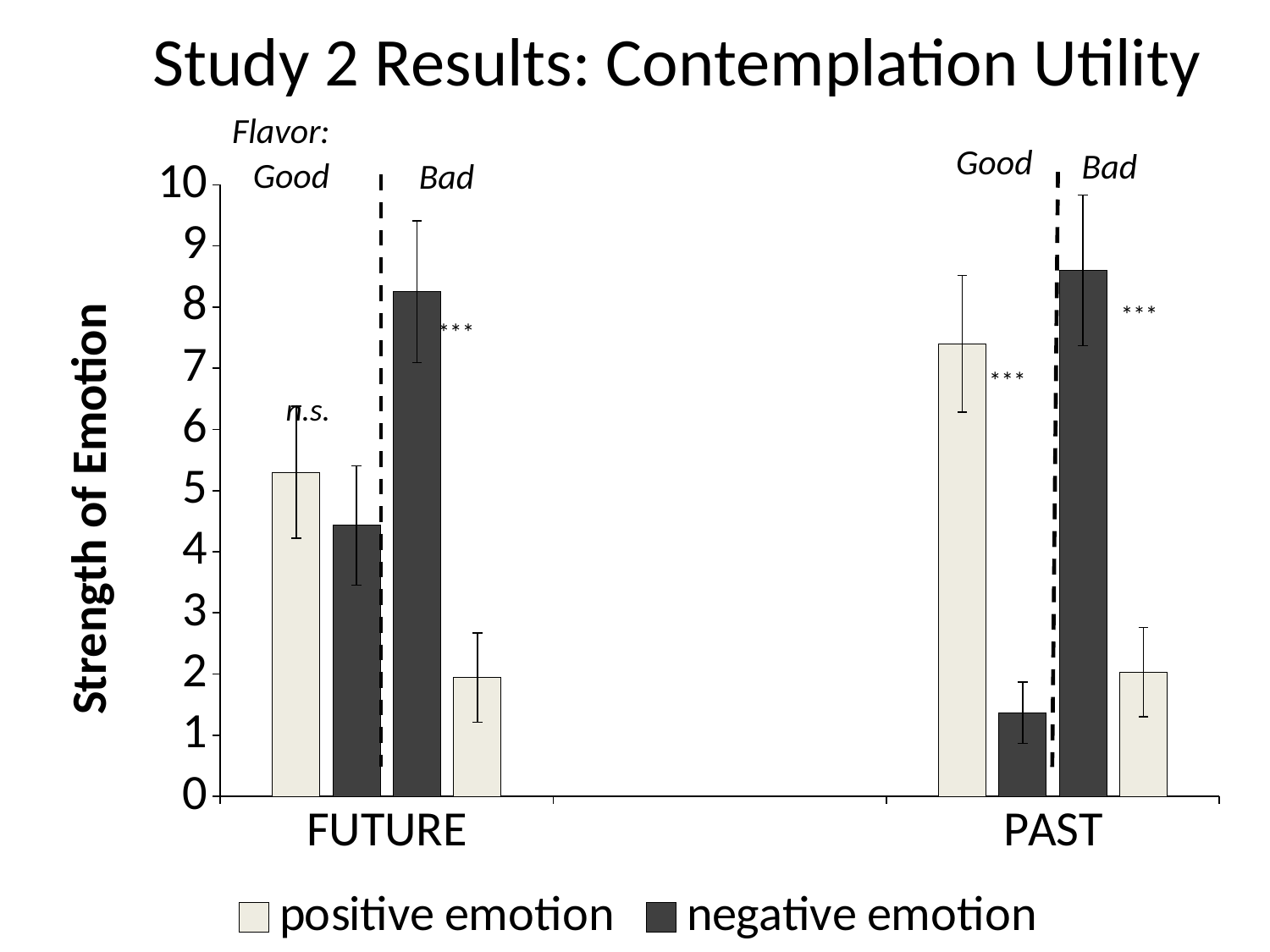
What kind of chart is shown on the slide? bar chart In the PAST condition with Good flavor, which is larger: positive emotion or negative emotion? positive emotion What is the label of the y axis? Strength of Emotion Is the positive emotion value for the Good flavor in the PAST condition greater or less than 7? greater How many categories are labelled on the x axis? 2 Is the positive emotion value for the Bad flavor in the FUTURE condition greater or less than 3? less In the FUTURE condition with Good flavor, which is larger: positive emotion or negative emotion? positive emotion Is the negative emotion value for the Good flavor in the PAST condition greater or less than 2? less In the PAST condition with Bad flavor, which is larger: positive emotion or negative emotion? negative emotion How many series does the legend list? 2 What are the two series named in the legend? positive emotion, negative emotion